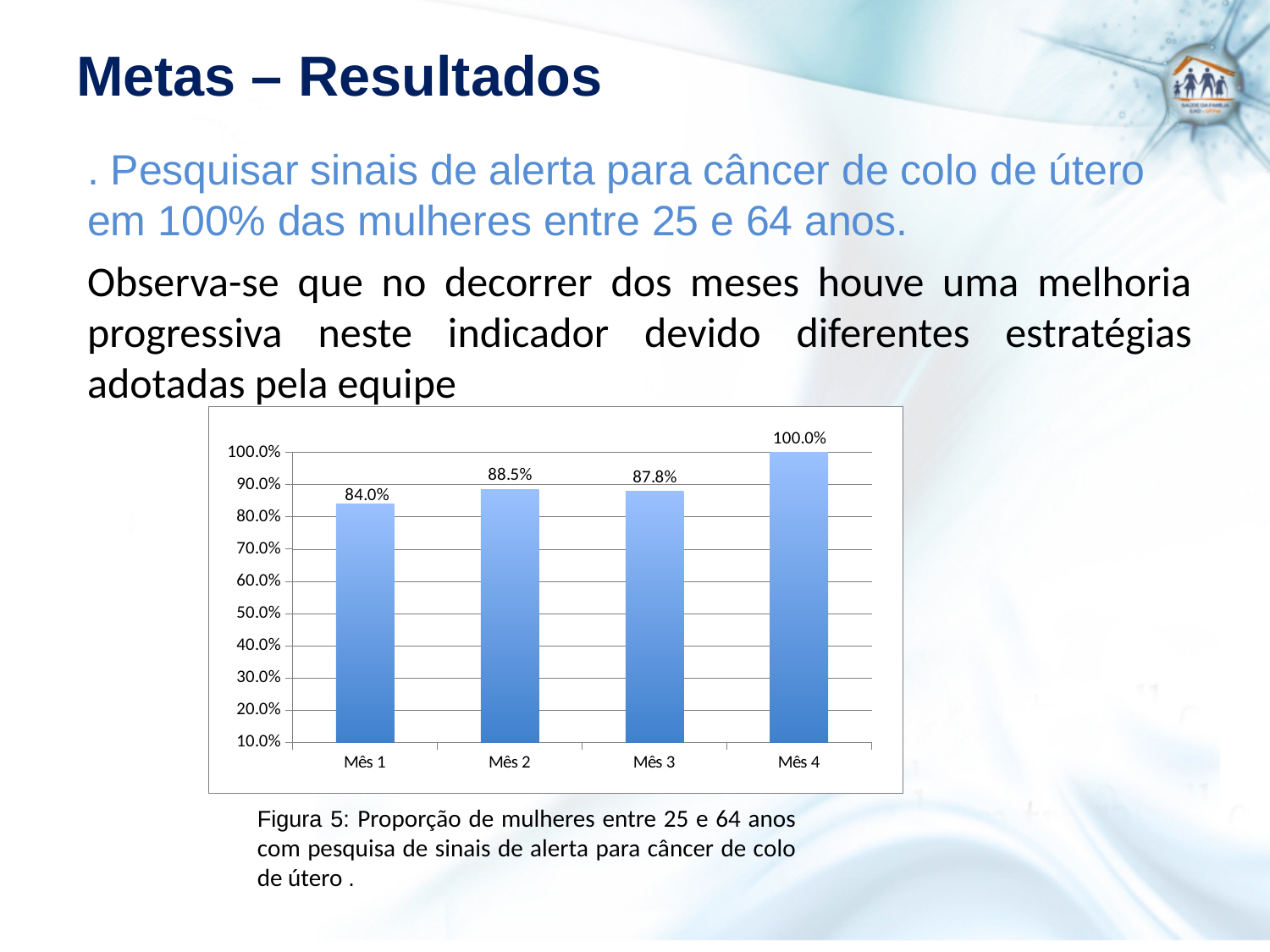
Which month has the lowest value? Mês 1 What is the value for Mês 4? 100.0% What is the figure caption below the chart? Figura 5: Proporção de mulheres entre 25 e 64 anos com pesquisa de sinais de alerta para câncer de colo de útero. What is the value for Mês 3? 87.8% What is the difference between the values for Mês 2 and Mês 3? 0.7% What is the value for Mês 1? 84.0% How many months are shown on the x axis? 4 What is the value for Mês 2? 88.5% What kind of chart is shown on the slide? Bar chart Which is larger, the value for Mês 2 or the value for Mês 1? Mês 2 What is the difference between the values for Mês 4 and Mês 1? 16.0% Which month has the highest value? Mês 4